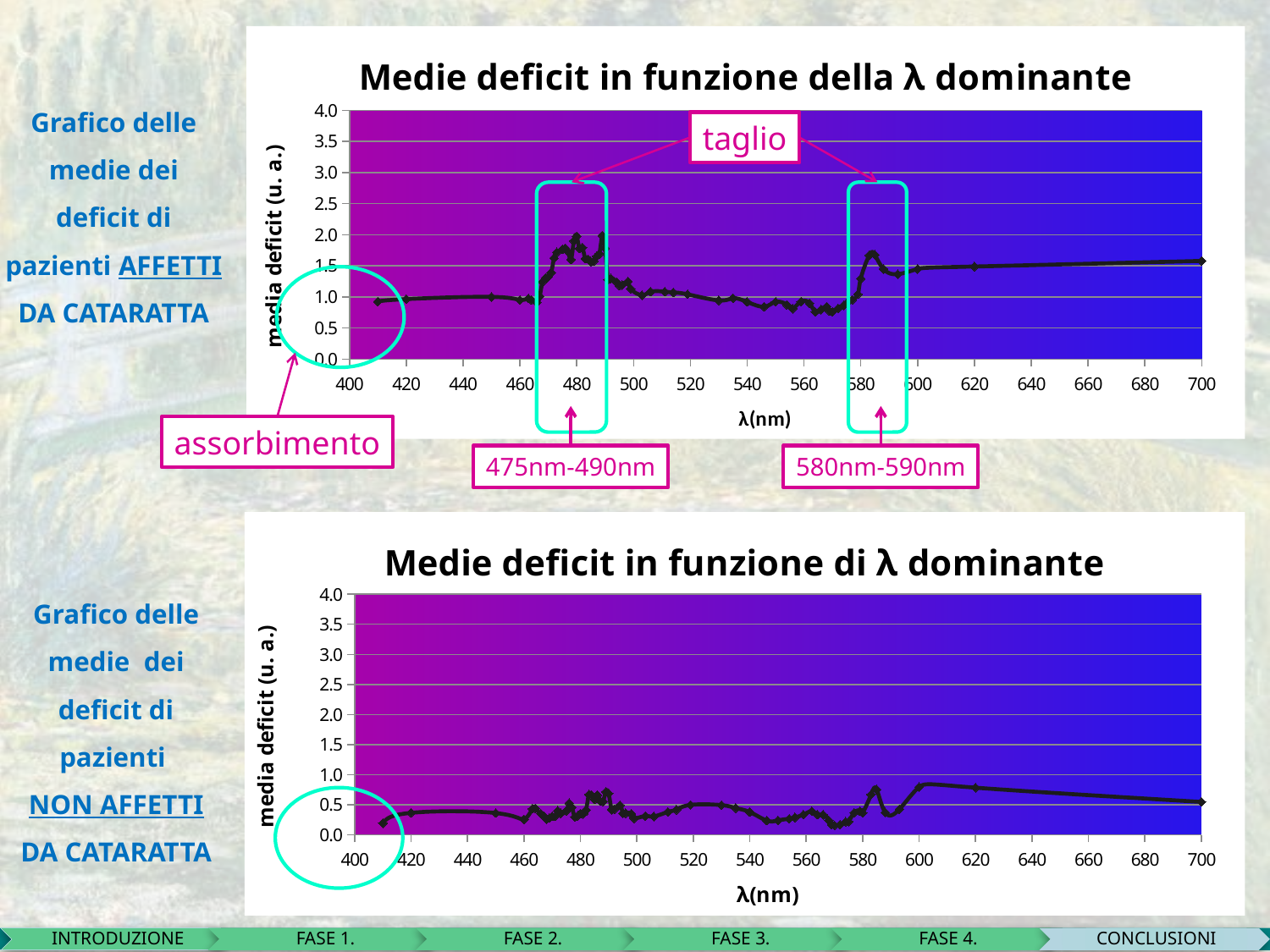
In the bottom chart, is the value at 440 nm greater or less than 0.5? less In the top chart, is the value at 560 nm greater or less than 1.5? less What is the label of the x axis on the bottom chart? λ(nm) In the top chart, does the line rise or fall between 600 nm and 700 nm? rise In the bottom chart, which is larger: the value at 600 nm or the value at 560 nm? 600 nm In the bottom chart, does the line rise or fall between 620 nm and 700 nm? fall In the bottom chart, is the value at 620 nm greater or less than 1.0? less In the top chart, in which of the two highlighted wavelength ranges does the line reach its highest value? 475nm-490nm What kind of chart is the top chart titled 'Medie deficit in funzione della λ dominante'? line chart What is the title of the bottom chart? Medie deficit in funzione di λ dominante In the top chart, which is larger: the value at 480 nm or the value at 560 nm? 480 nm